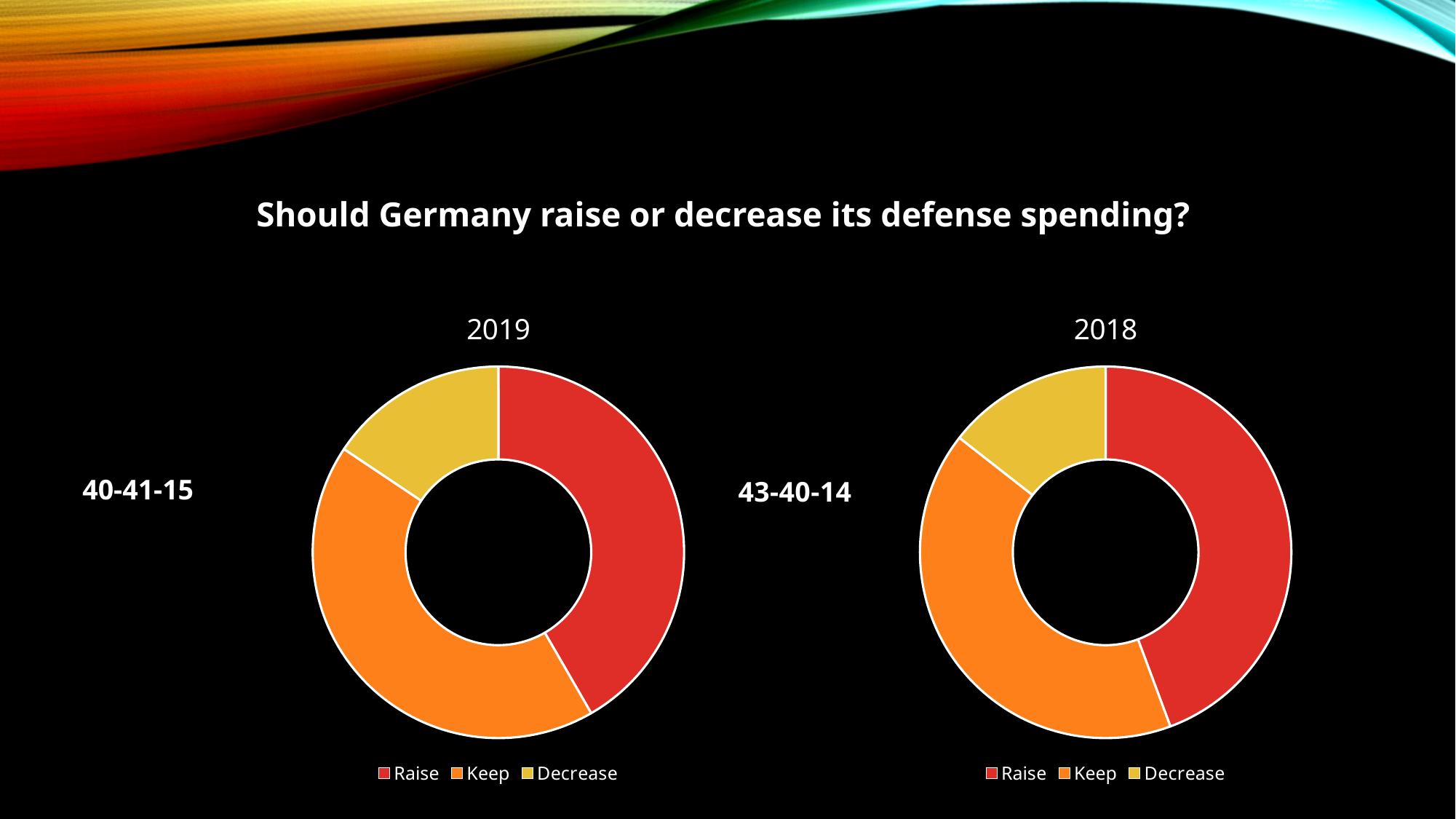
In the 2018 chart, which category has the smallest slice? Decrease What is the difference between the Raise value in the 2018 chart and the Raise value in the 2019 chart? 3 How many categories does the legend of the 2018 chart list? 3 In the 2019 chart, which category has the smallest slice? Decrease What kind of chart is used for the 2019 data? Doughnut chart In the 2019 chart, what value is printed for Keep? 41 In the 2019 chart, what value is printed for Decrease? 15 Which colour represents Raise in the legend of the 2019 chart? Red In the 2018 chart, what value is printed for Decrease? 14 In the 2018 chart, what value is printed for Raise? 43 What is the title shown above the charts? Should Germany raise or decrease its defense spending? How many charts are shown on the slide? 2